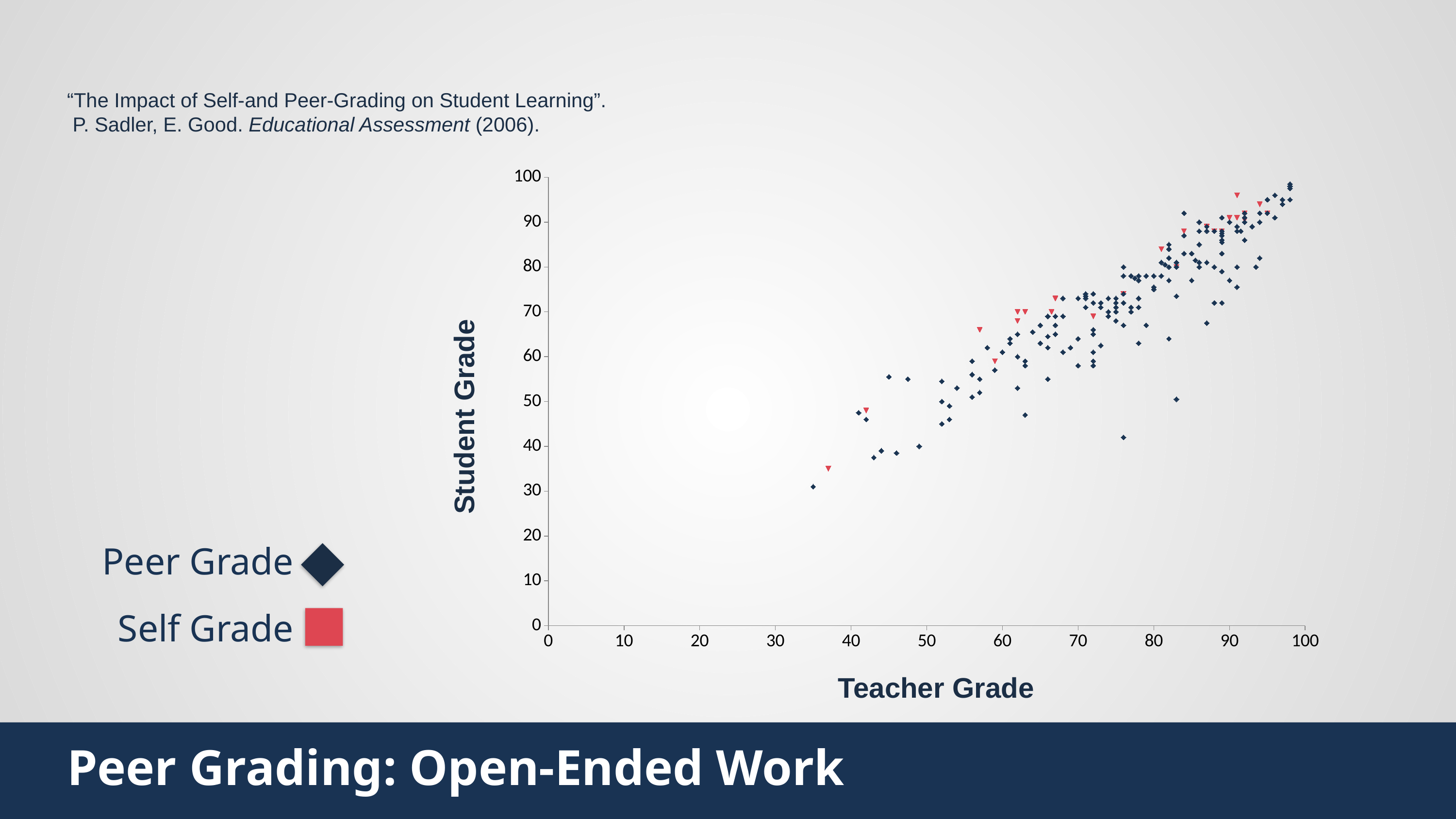
Is the lowest Teacher Grade plotted greater or less than 30? greater Is the highest Student Grade plotted greater or less than 90? greater Which series is shown with red markers? Self Grade What is the label of the x axis? Teacher Grade Is the highest Teacher Grade plotted greater or less than 90? greater How many series does the legend list? 2 As Teacher Grade increases along the x axis, do the Student Grade values generally rise or fall? Rise What kind of chart is shown on the slide? Scatter chart